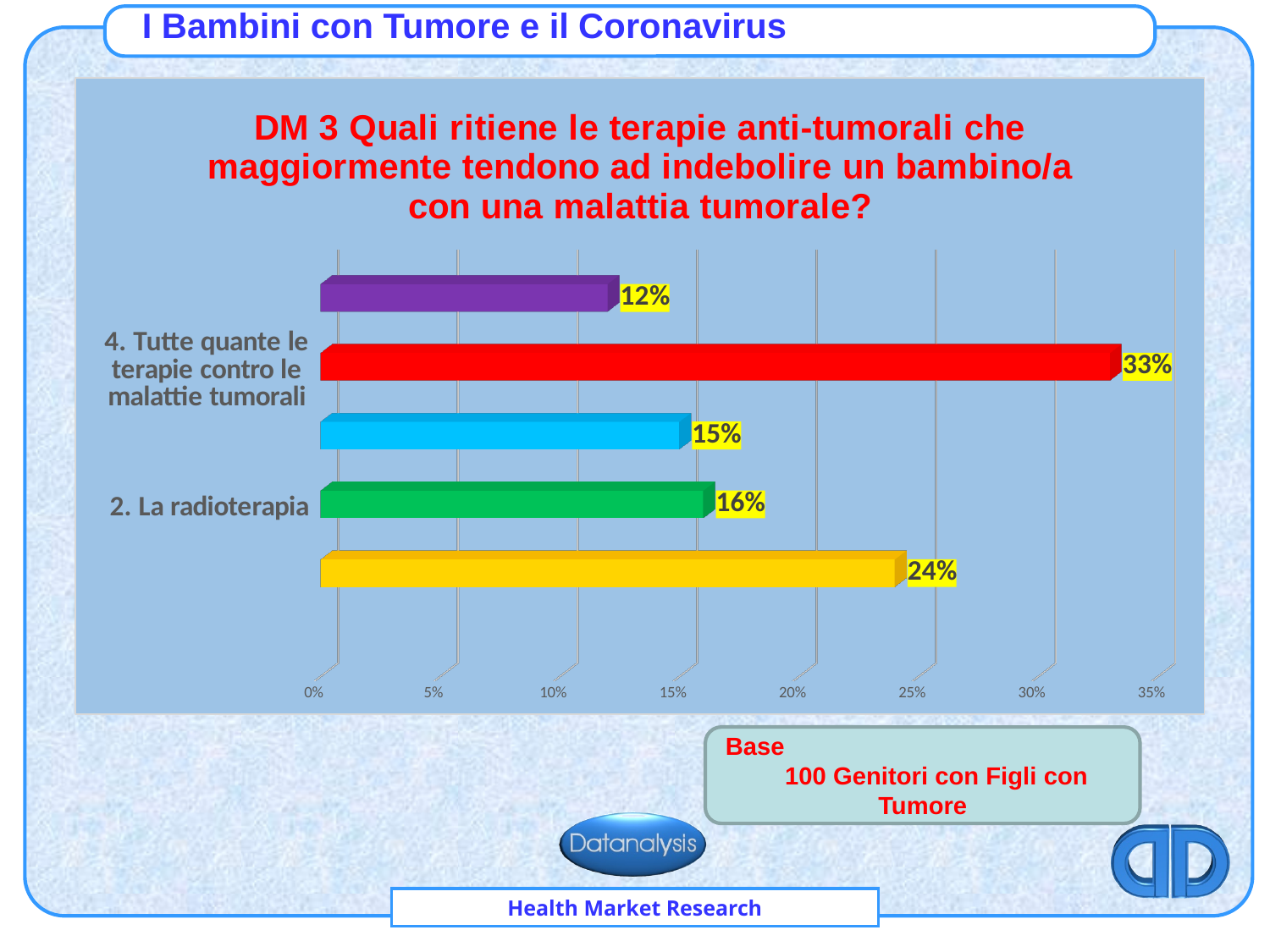
Which is larger, the value for "4. Tutte quante le terapie contro le malattie tumorali" or the value for "2. La radioterapia"? 4. Tutte quante le terapie contro le malattie tumorali What kind of chart is shown on the slide? Bar chart Is the value of the purple bar greater or less than 15%? less How many bars are plotted in the chart? 5 Which category has the highest value in the chart? 4. Tutte quante le terapie contro le malattie tumorali What is the highest value shown in the chart? 33% Is the value of the yellow bar greater or less than 20%? greater What colour is the bar for "2. La radioterapia"? Green What is the difference between the values for "4. Tutte quante le terapie contro le malattie tumorali" and "2. La radioterapia"? 17 percentage points What is the value for "2. La radioterapia"? 16% What is the value for "4. Tutte quante le terapie contro le malattie tumorali"? 33% What is the lowest value shown in the chart? 12%